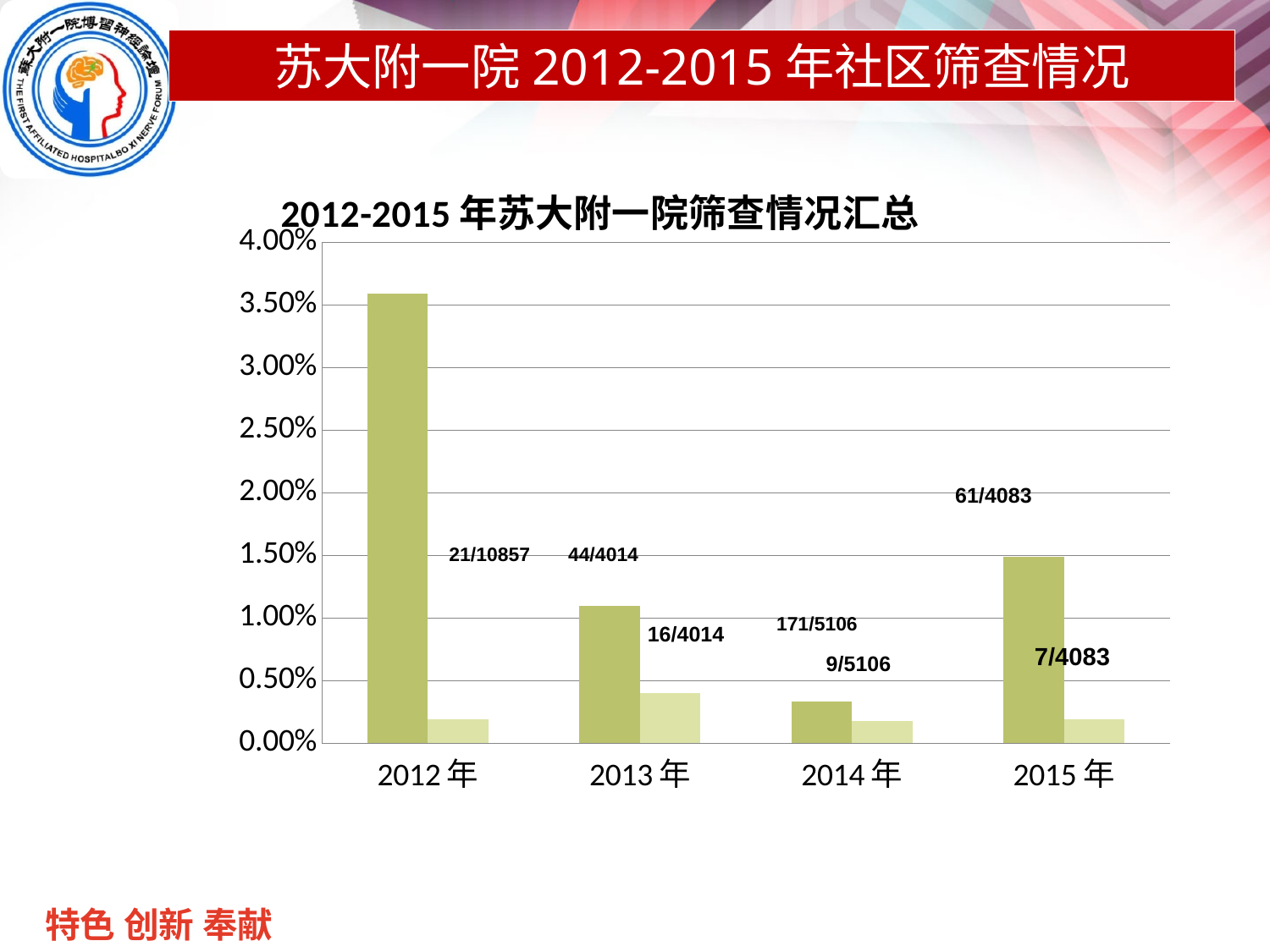
Is the darker green bar for 2013年 greater or less than 1.50%? less What is the title of the chart? 2012-2015年苏大附一院筛查情况汇总 Do the darker green bars rise or fall from 2012年 to 2014年? fall Which year has the tallest lighter green bar? 2013年 Is the darker green bar for 2014年 greater or less than 0.50%? less What kind of chart is shown on the slide? bar chart Which year has the tallest darker green bar? 2012年 Which year has the shortest darker green bar? 2014年 Which darker green bar is taller, 2013年 or 2015年? 2015年 Is the darker green bar for 2012年 greater or less than 3.00%? greater How many year categories are shown on the x axis of the chart? 4